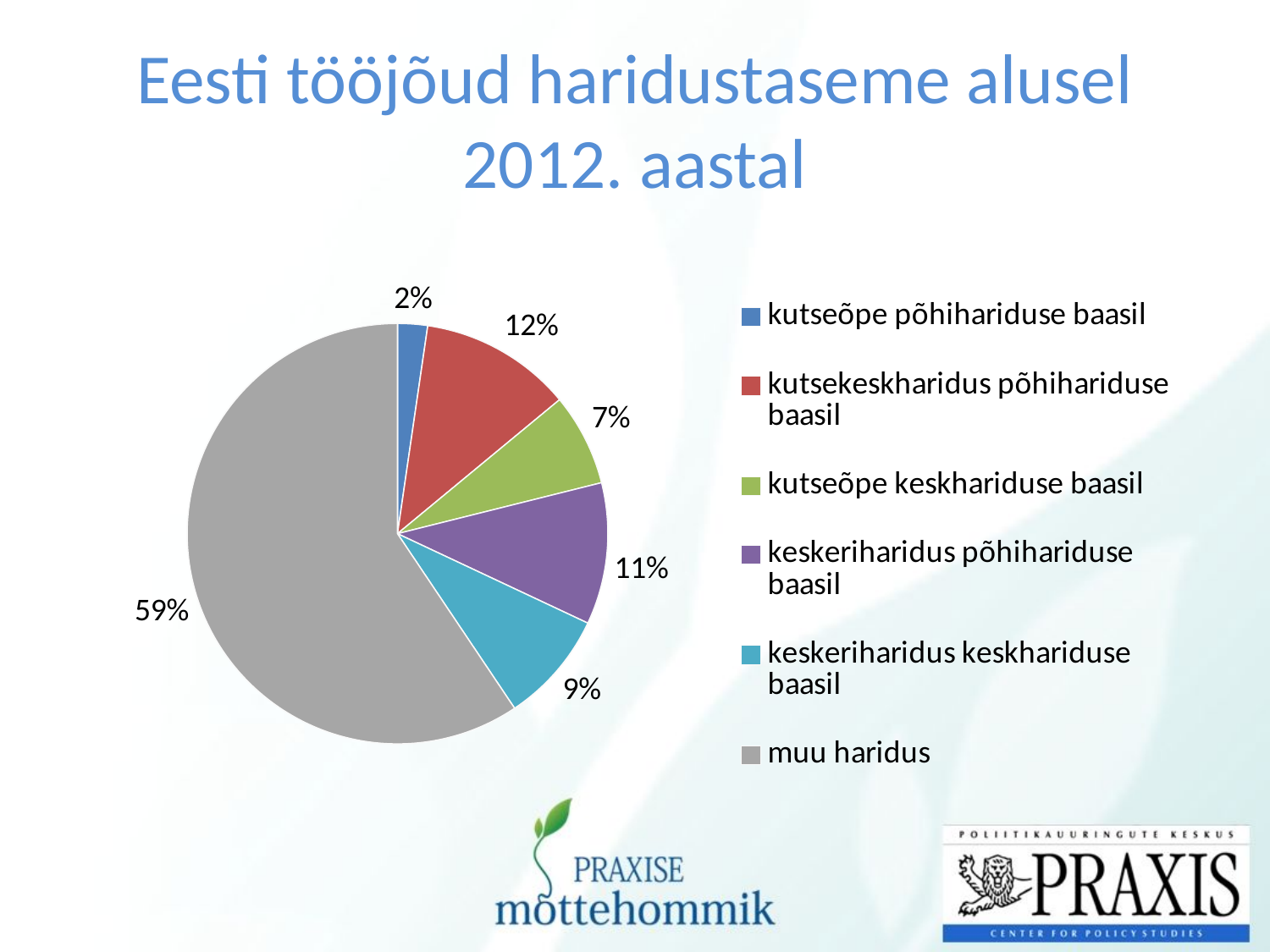
Which category has the smallest slice of the pie? kutseõpe põhihariduse baasil Which is larger, "keskeriharidus põhihariduse baasil" or "keskeriharidus keskhariduse baasil"? keskeriharidus põhihariduse baasil What is the value for "kutsekeskharidus põhihariduse baasil"? 12% How many categories does the pie chart have? 6 What is the value for "keskeriharidus keskhariduse baasil"? 9% What kind of chart is shown on the slide? pie chart Which category has the largest slice of the pie? muu haridus What is the title of the slide containing the chart? Eesti tööjõud haridustaseme alusel 2012. aastal What is the value for "kutseõpe keskhariduse baasil"? 7% What share of the pie does "muu haridus" hold? 59% What is the difference between the values for "kutsekeskharidus põhihariduse baasil" and "kutseõpe keskhariduse baasil"? 5% What is the value for "keskeriharidus põhihariduse baasil"? 11%